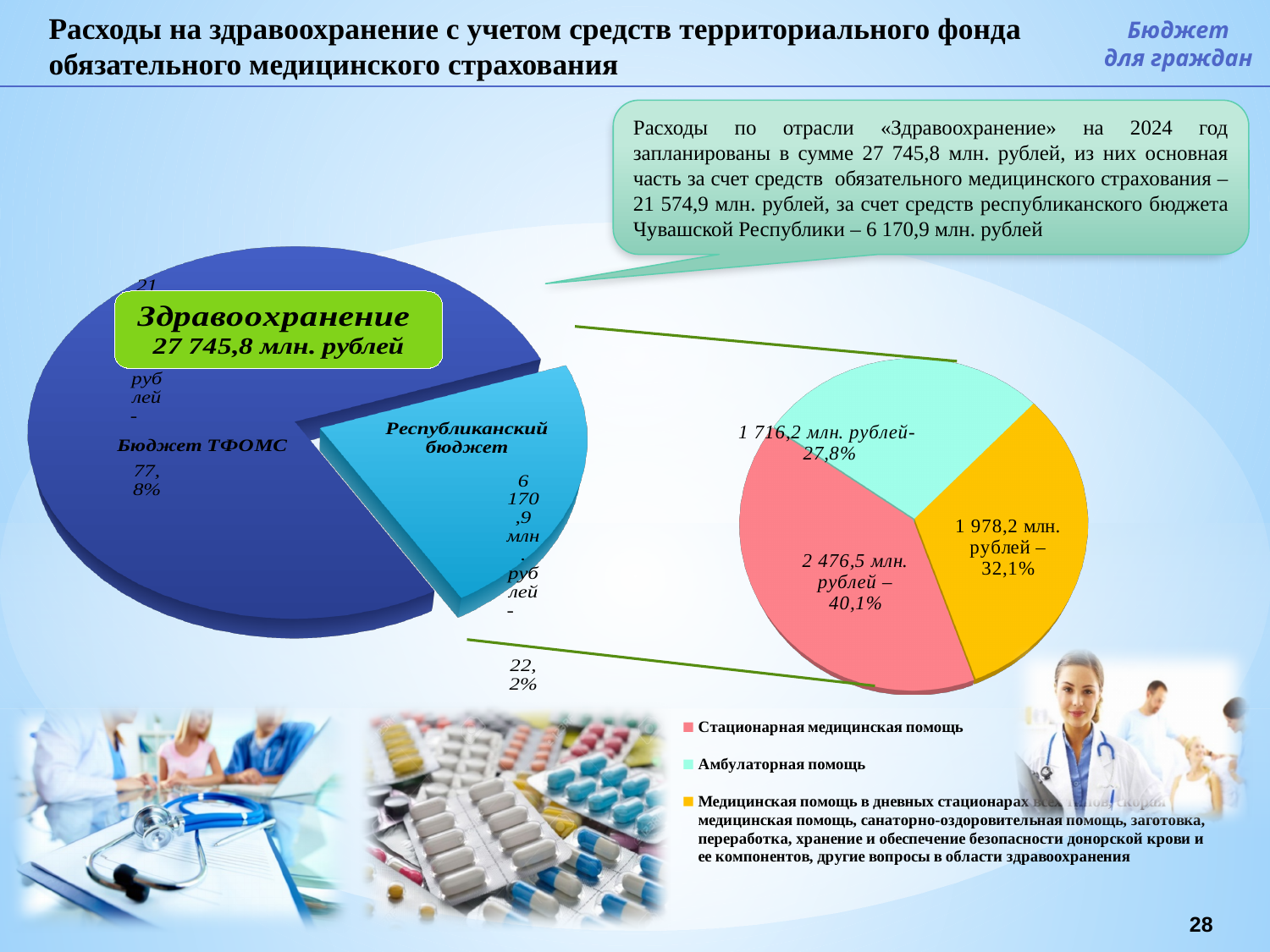
What kind of chart is the left chart on the slide? pie chart In the right pie chart, which category has the largest slice? Стационарная медицинская помощь In the left pie chart, what value in млн. рублей is shown for Республиканский бюджет? 6 170,9 млн. рублей What kind of chart is the right chart on the slide? pie chart How many slices does the right pie chart have? 3 In the left pie chart, which slice is larger: Бюджет ТФОМС or Республиканский бюджет? Бюджет ТФОМС In the left pie chart, what share is shown for Бюджет ТФОМС? 77,8% In the right pie chart, which category has the smallest slice? Амбулаторная помощь In the left pie chart, what share is shown for Республиканский бюджет? 22,2% In the right pie chart, what is the difference in percentage points between the 40,1% slice and the 32,1% slice? 8 percentage points In the right pie chart, what share is shown for Амбулаторная помощь? 27,8% In the right pie chart, what value is shown for Стационарная медицинская помощь? 2 476,5 млн. рублей